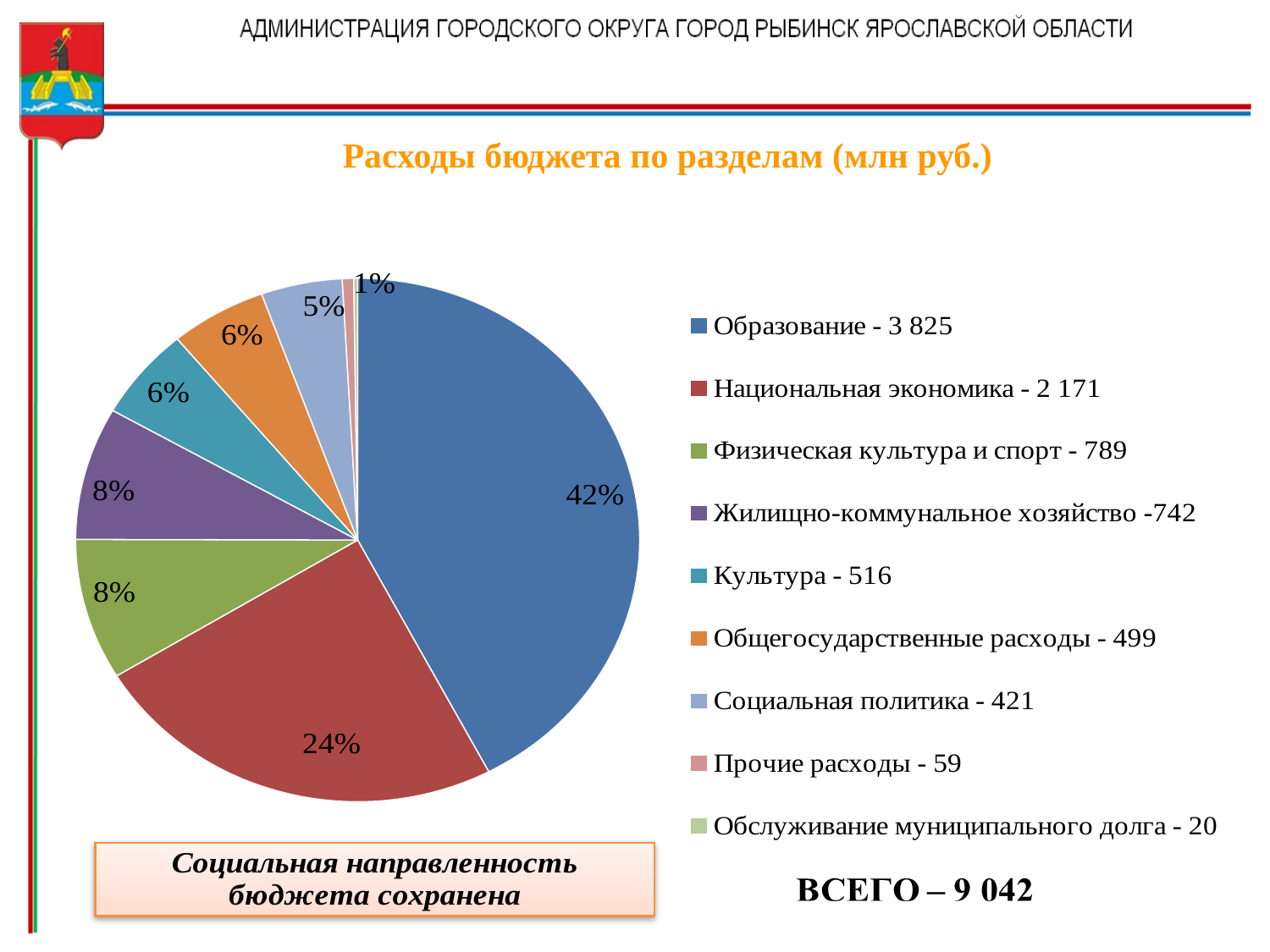
What kind of chart is shown on the slide? pie chart Which category has the largest share of the pie? Образование What is the value for Образование? 3 825 What share of the pie does Национальная экономика take? 24% Which category has the smallest value? Обслуживание муниципального долга Which is larger, the value for Физическая культура и спорт or the value for Жилищно-коммунальное хозяйство? Физическая культура и спорт What is the value for Обслуживание муниципального долга? 20 What is the value for Национальная экономика? 2 171 What is the difference between the values for Образование and Национальная экономика? 1 654 How many categories does the legend list? 9 What is the value for Культура? 516 What is the title of the chart? Расходы бюджета по разделам (млн руб.)